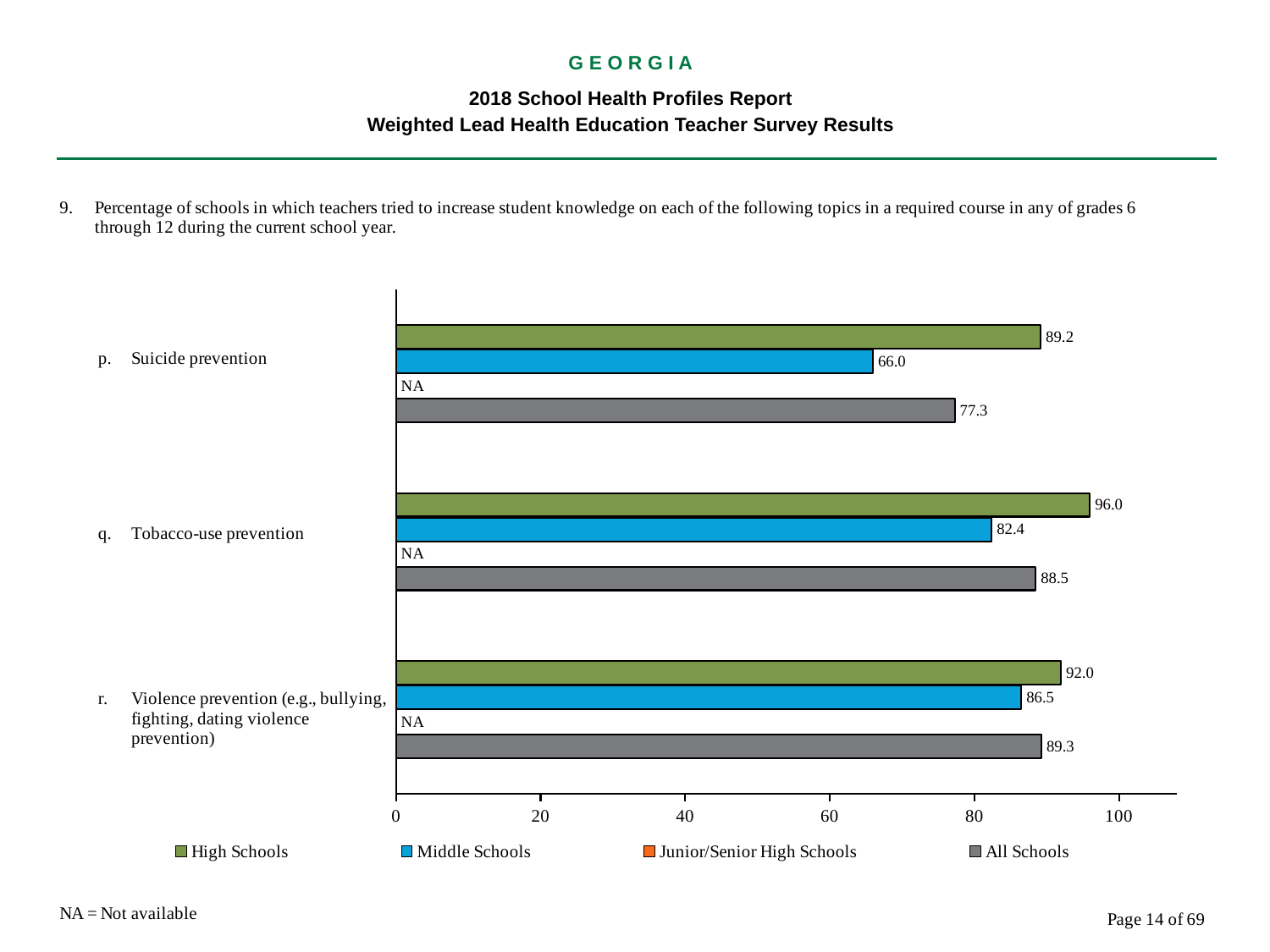
What kind of chart is shown on the slide? Bar chart What value is shown for Junior/Senior High Schools for each topic? NA How many series does the legend list? 4 What is the difference between the High Schools and Middle Schools values for Suicide prevention? 23.2 What is the value for High Schools for Tobacco-use prevention? 96.0 Which is larger for Tobacco-use prevention: the Middle Schools value or the All Schools value? All Schools Which topic has the lowest value for Middle Schools? Suicide prevention Is the Middle Schools value for Violence prevention greater or less than 80? greater How many topics are shown on the chart? 3 What is the value for All Schools for Violence prevention? 89.3 What is the value for Middle Schools for Suicide prevention? 66.0 Which topic has the highest value for High Schools? Tobacco-use prevention